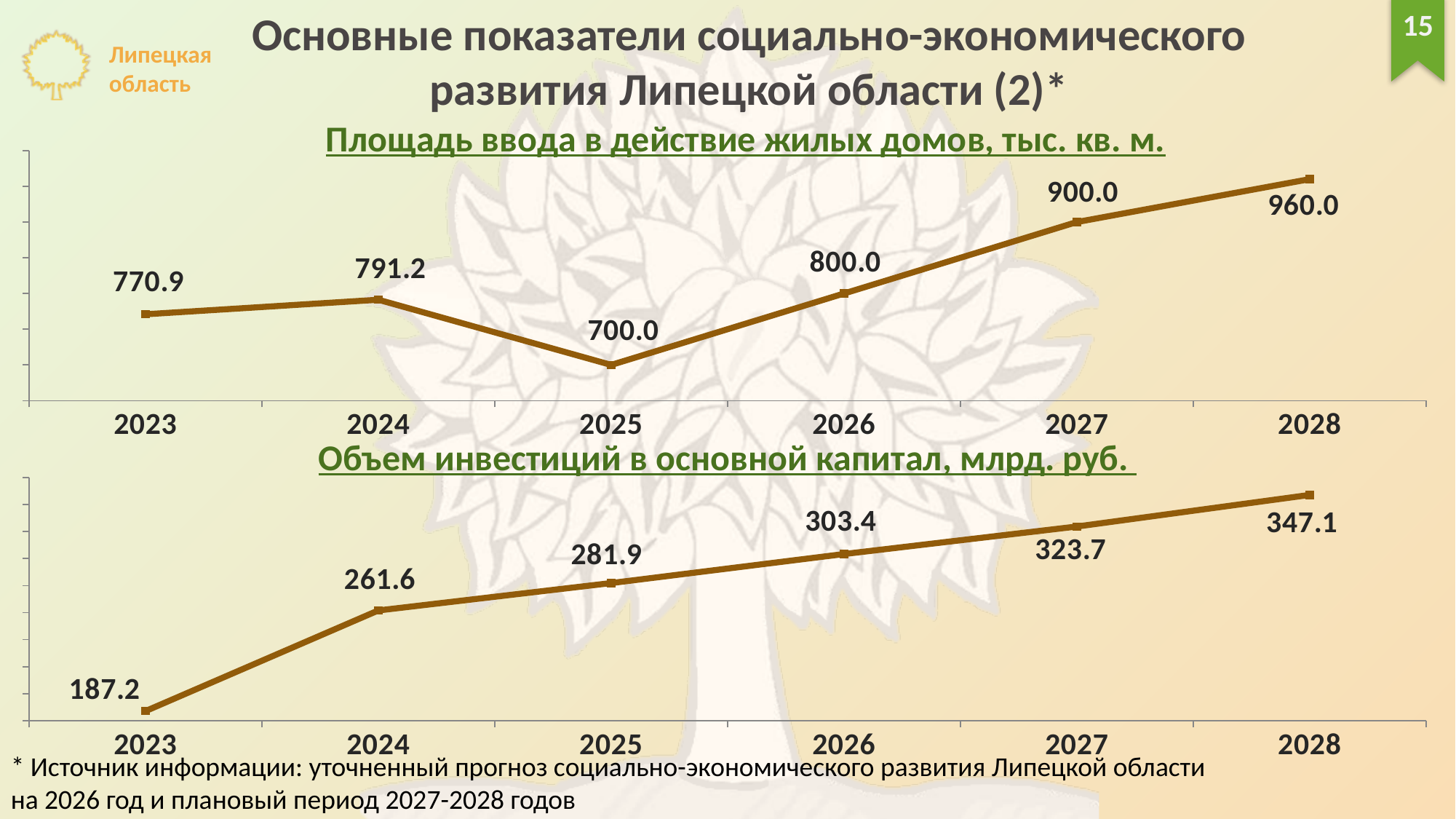
How many years are plotted in the chart 'Объем инвестиций в основной капитал, млрд. руб.'? 6 In the chart 'Площадь ввода в действие жилых домов, тыс. кв. м.', what is the value for 2025? 700.0 In the chart 'Объем инвестиций в основной капитал, млрд. руб.', do the values rise or fall from 2023 to 2028? rise What kind of chart is the top chart 'Площадь ввода в действие жилых домов, тыс. кв. м.'? line chart In the chart 'Объем инвестиций в основной капитал, млрд. руб.', which year has the highest value? 2028 In the chart 'Площадь ввода в действие жилых домов, тыс. кв. м.', which is larger, the value for 2023 or the value for 2024? 2024 In the chart 'Площадь ввода в действие жилых домов, тыс. кв. м.', which year has the highest value? 2028 In the chart 'Объем инвестиций в основной капитал, млрд. руб.', what is the value for 2027? 323.7 In the chart 'Площадь ввода в действие жилых домов, тыс. кв. м.', what is the difference between the values for 2028 and 2027? 60.0 In the chart 'Площадь ввода в действие жилых домов, тыс. кв. м.', which year has the lowest value? 2025 In the chart 'Объем инвестиций в основной капитал, млрд. руб.', what is the value for 2023? 187.2 In the chart 'Объем инвестиций в основной капитал, млрд. руб.', what is the difference between the values for 2024 and 2023? 74.4